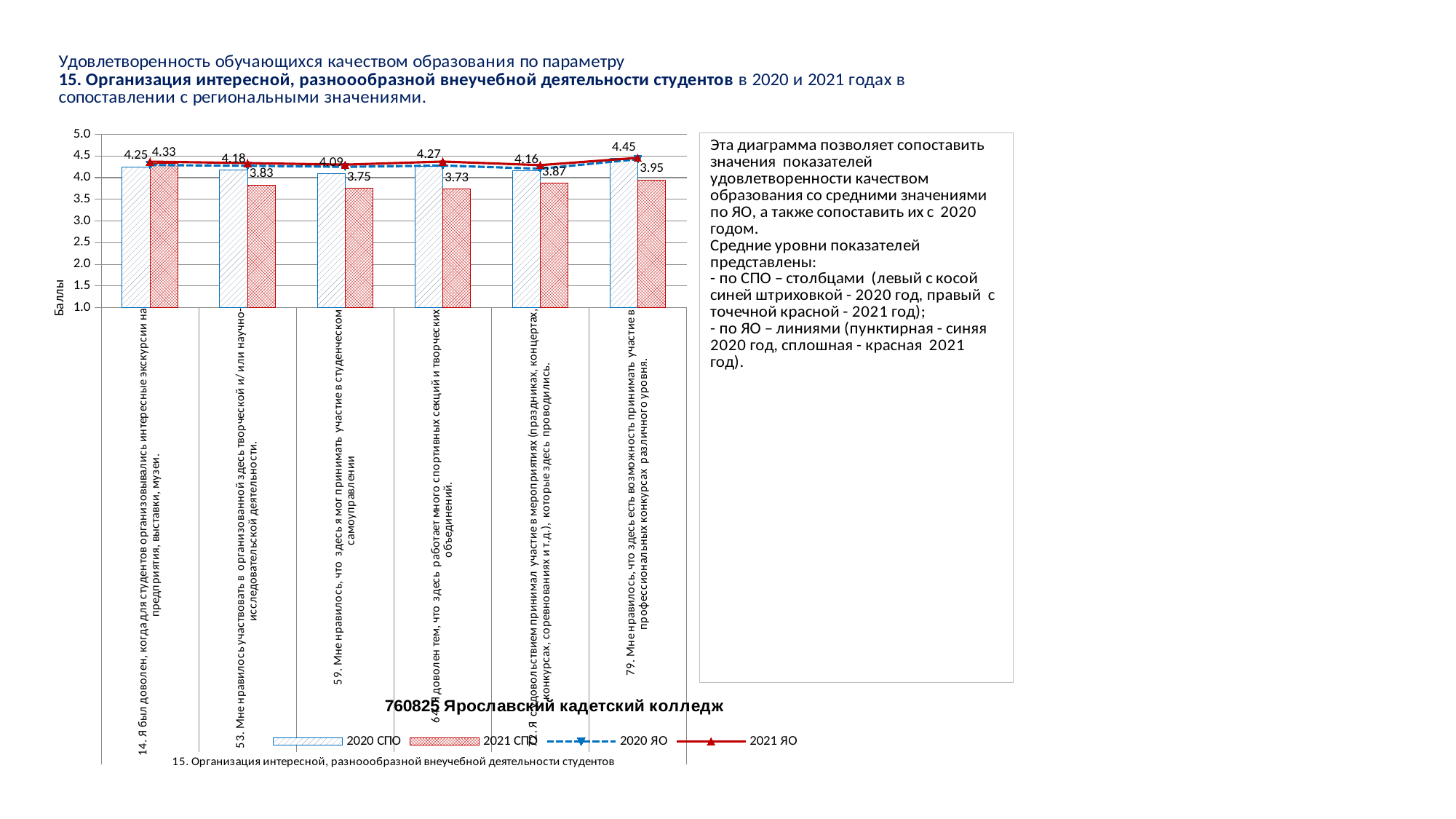
Which category has the lowest 2021 СПО value? 64. Я доволен тем, что здесь работает много спортивных секций и творческих объединений (3.73) What is the 2021 СПО value for item 79 (participation in professional competitions of various levels)? 3.95 What type of chart is shown on the slide? Combined bar and line chart What is the 2020 СПО value for item 14 (excursions to enterprises, exhibitions, museums)? 4.25 How many categories (survey items) are shown on the x axis of the chart? 6 Is the 2021 СПО value for item 53 (creative and/or research activity) greater or less than 4.0? less What is the 2020 СПО value for item 64 (many sports sections and creative associations)? 4.27 Which category has the highest 2020 СПО value? 79. Мне нравилось, что здесь есть возможность принимать участие в профессиональных конкурсах различного уровня (4.45) For item 14, which is larger: the 2020 СПО value or the 2021 СПО value? 2021 СПО (4.33) How many series does the chart legend list? 4 What is the difference between the 2020 СПО and 2021 СПО values for item 59 (student self-government)? 0.34 What is the difference between the 2020 СПО and 2021 СПО values for item 79? 0.50